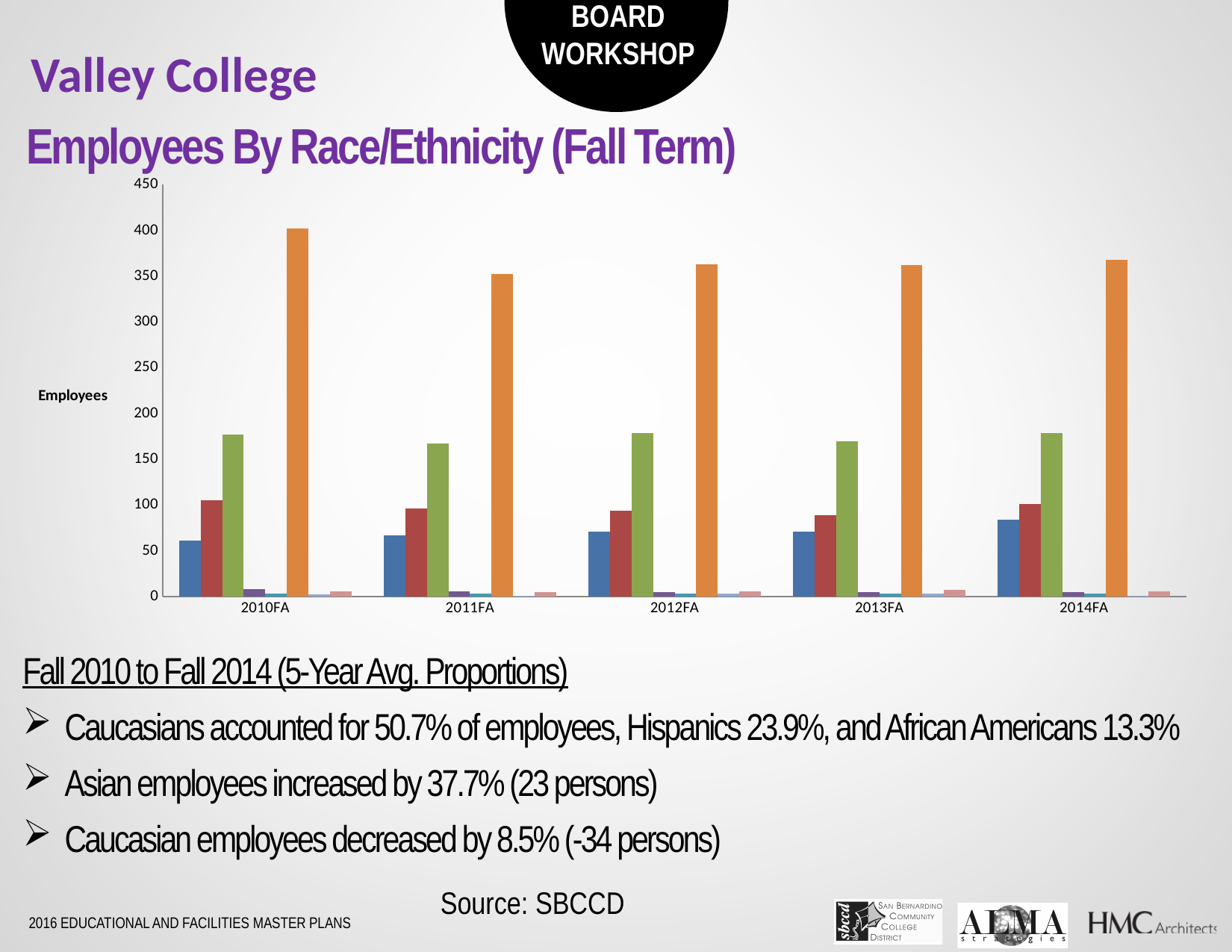
In which fall term is the orange bar the tallest? 2010FA Is the orange bar for 2011FA greater or less than 400? less Is the blue bar for 2012FA greater or less than 50? greater How many fall terms are shown along the x axis of the chart? 5 Is the orange bar for 2010FA greater or less than 350? greater What is the label on the vertical axis of the chart? Employees In 2014FA, which is larger, the green bar or the orange bar? the orange bar What is the title of the chart? Employees By Race/Ethnicity (Fall Term) In which fall term is the blue bar the tallest? 2014FA What kind of chart is shown on the slide? bar chart In 2010FA, which is larger, the blue bar or the red bar? the red bar